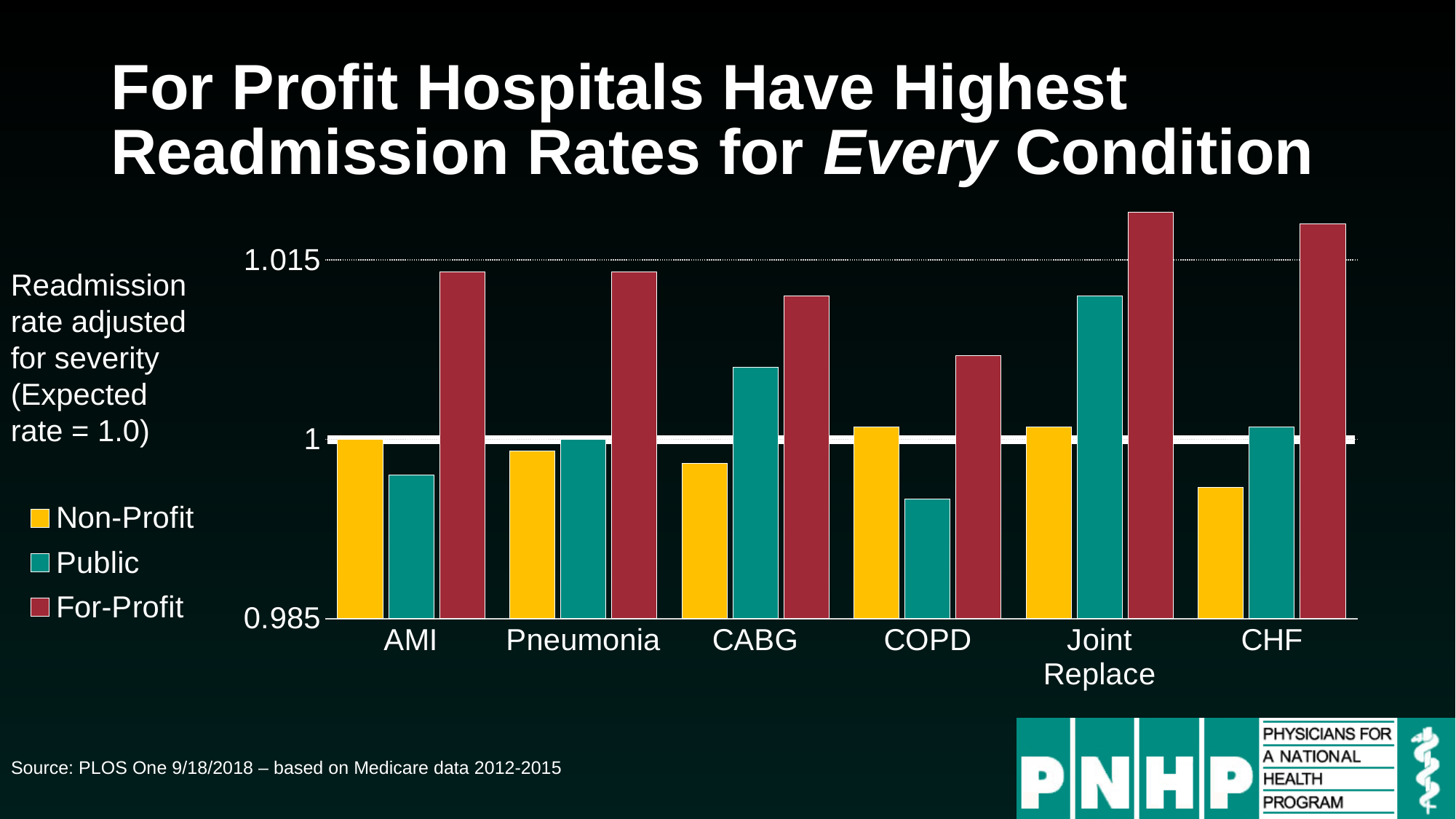
What kind of chart is shown on the slide? bar chart Which series does the red colour represent in the chart? For-Profit Which condition has the lowest Non-Profit readmission rate? CHF Is the Non-Profit value for CHF greater or less than 1? less How many conditions are shown along the x axis of the chart? 6 Is the For-Profit value for Joint Replace greater or less than 1.015? greater For CABG, which is larger: the Public value or the Non-Profit value? Public Is the For-Profit value for AMI greater or less than 1? greater Which condition has the lowest Public readmission rate? COPD Which condition has the highest Public readmission rate? Joint Replace How many series does the chart's legend list? 3